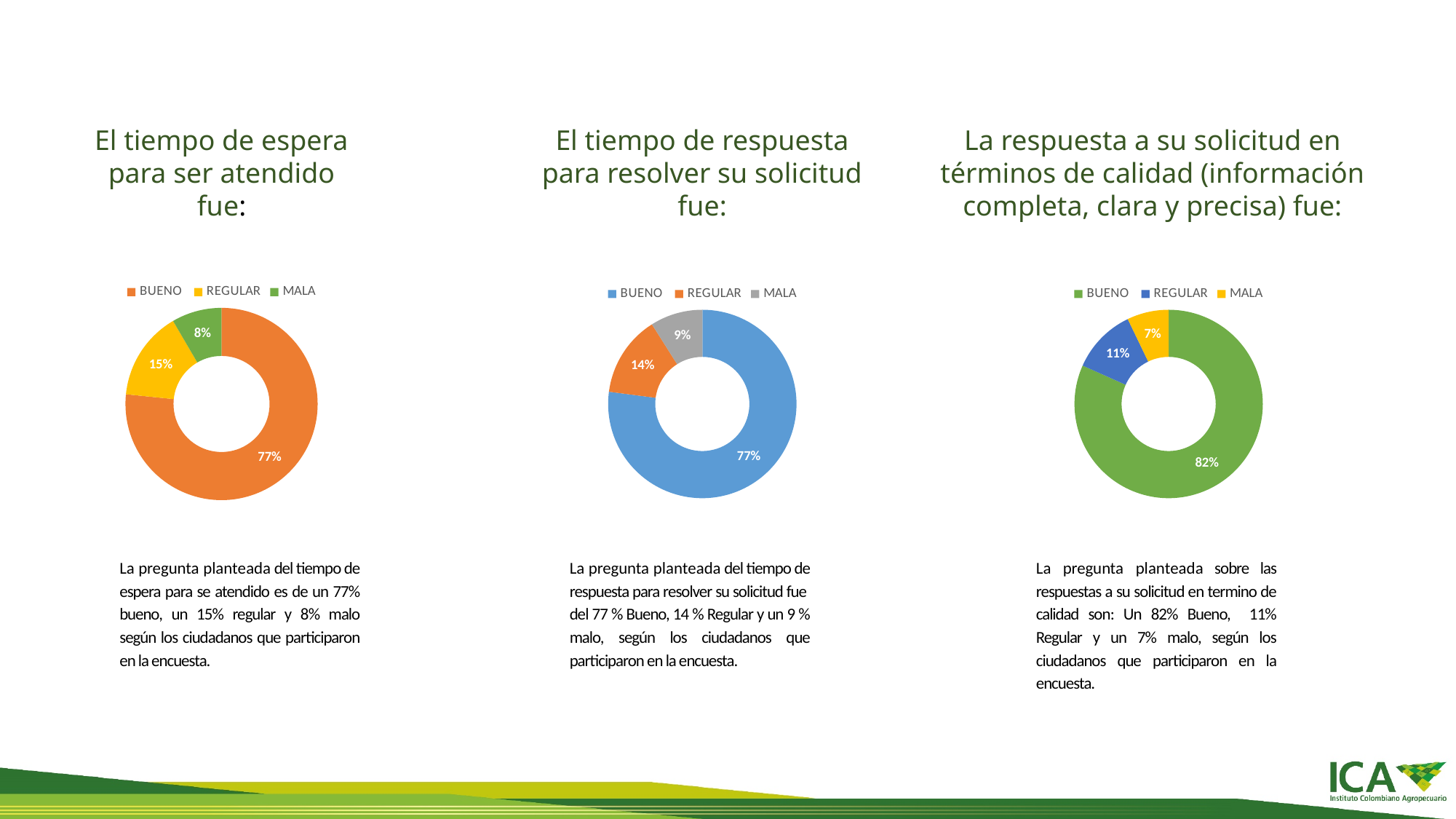
How many categories does the legend of the middle chart list? 3 In the middle chart ('El tiempo de respuesta para resolver su solicitud fue:'), what percentage is MALA? 9% How many charts are shown on the slide? 3 In the right chart ('La respuesta a su solicitud en términos de calidad...'), which is larger, REGULAR or MALA? REGULAR In the left chart ('El tiempo de espera para ser atendido fue:'), what percentage is REGULAR? 15% What kind of chart is used on this slide? Doughnut (pie) chart In the middle chart ('El tiempo de respuesta para resolver su solicitud fue:'), which category has the largest share? BUENO In the left chart ('El tiempo de espera para ser atendido fue:'), what percentage is BUENO? 77% In the middle chart ('El tiempo de respuesta para resolver su solicitud fue:'), what colour is the BUENO segment? Blue In the left chart ('El tiempo de espera para ser atendido fue:'), what is the difference between the REGULAR and MALA shares? 7% In the right chart ('La respuesta a su solicitud en términos de calidad...'), which category has the smallest share? MALA In the right chart ('La respuesta a su solicitud en términos de calidad...'), what percentage is BUENO? 82%